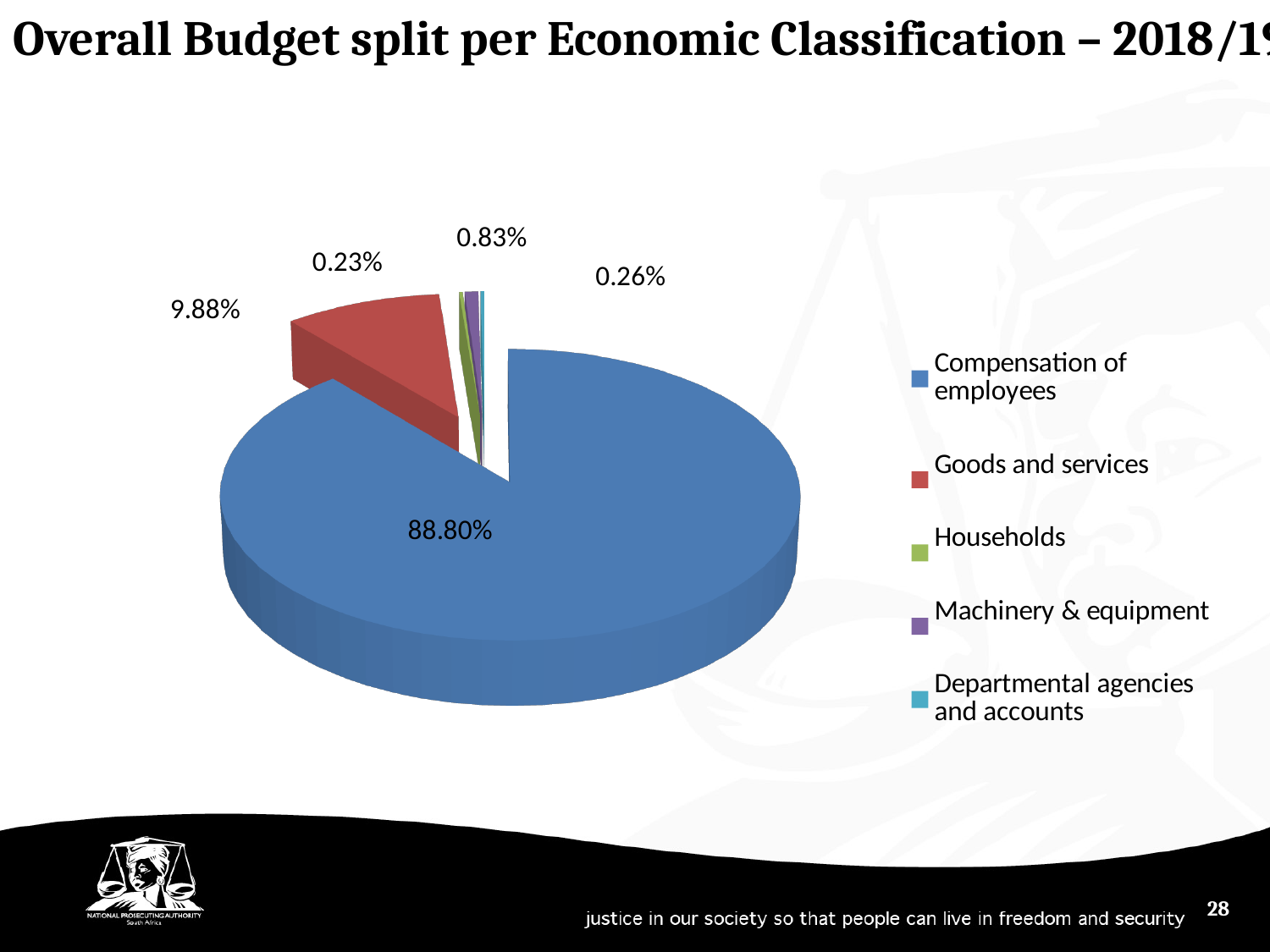
What is the title of the slide containing the chart? Overall Budget split per Economic Classification – 2018/19 What share of the overall budget goes to Compensation of employees? 88.80% What share of the overall budget goes to Goods and services? 9.88% Which economic classification has the largest share of the budget? Compensation of employees Which is larger, the share for Compensation of employees or the share for Goods and services? Compensation of employees What colour represents Goods and services in the legend? red How many economic classifications does the legend list? 5 What is the difference in percentage points between the Compensation of employees share and the Goods and services share? 78.92% What kind of chart is shown on the slide? pie chart